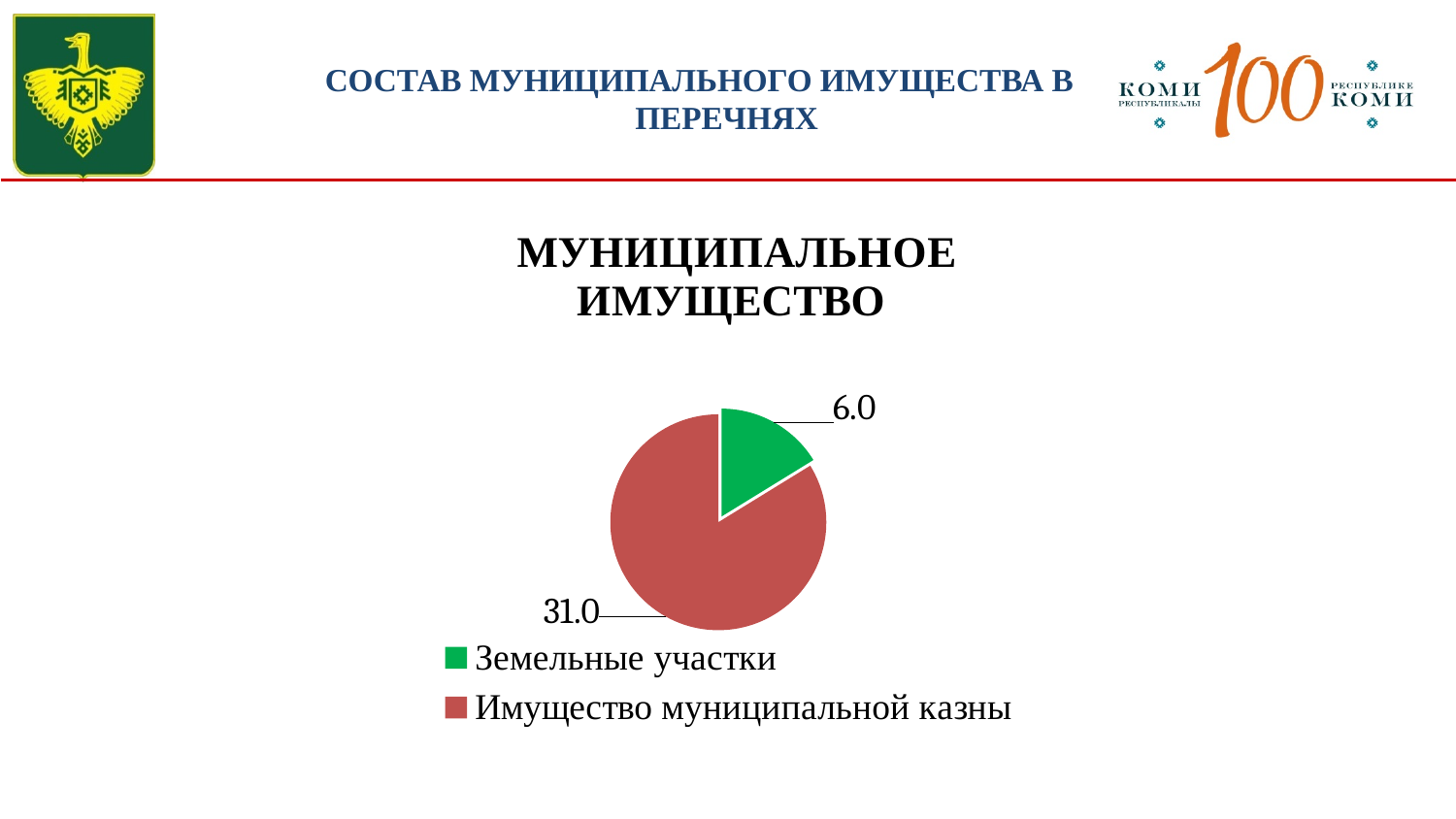
What type of chart is shown on the slide? Pie chart How many slices does the pie chart have? 2 What is the value for Имущество муниципальной казны? 31.0 What is the total of the two values shown in the pie chart? 37.0 Which category has the largest slice of the pie? Имущество муниципальной казны What is the title of the chart? МУНИЦИПАЛЬНОЕ ИМУЩЕСТВО How many entries does the legend list? 2 Which category has the smallest slice of the pie? Земельные участки What is the difference between the values for Имущество муниципальной казны and Земельные участки? 25.0 Which is larger: Земельные участки or Имущество муниципальной казны? Имущество муниципальной казны What is the value for Земельные участки? 6.0 What colour is the slice for Земельные участки? Green